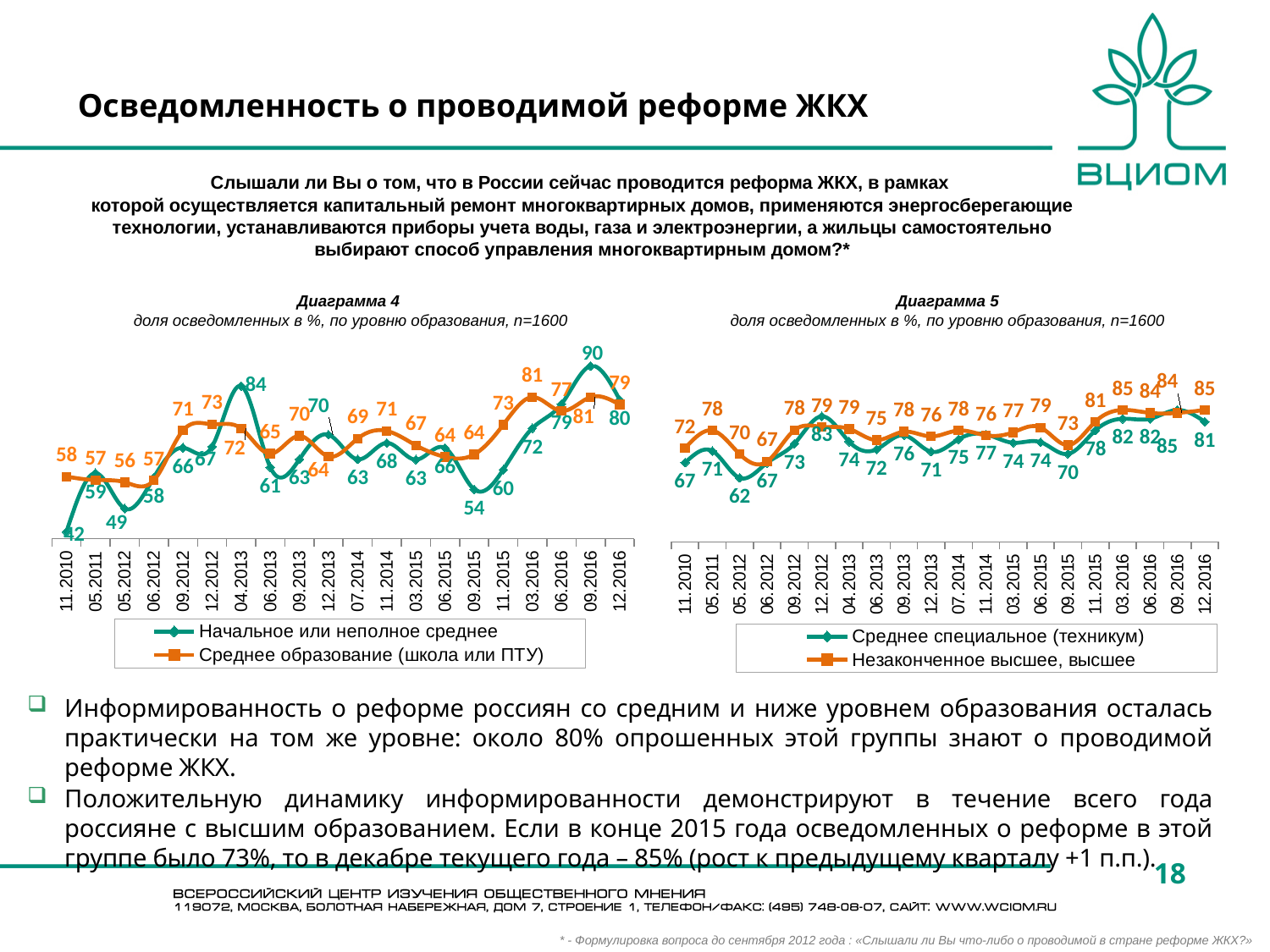
How many time points are plotted on Диаграмма 5? 20 On Диаграмма 4, in which period does 'Начальное или неполное среднее' reach its highest value? 09.2016 On Диаграмма 5, what is the value for 'Среднее специальное (техникум)' in 12.2012? 83 On Диаграмма 4, what is the value for 'Начальное или неполное среднее' in 09.2016? 90 On Диаграмма 5, which series has the larger value in 05.2012? Незаконченное высшее, высшее On Диаграмма 5, in which period does 'Среднее специальное (техникум)' reach its lowest value? 05.2012 On Диаграмма 5, what is the value for 'Незаконченное высшее, высшее' in 12.2016? 85 What type of chart is Диаграмма 4? Line chart On Диаграмма 4, what is the difference between the two series in 09.2016? 9 On Диаграмма 4, what is the value for 'Среднее образование (школа или ПТУ)' in 03.2016? 81 How many series does the legend of Диаграмма 4 list? 2 On Диаграмма 4, in which period does 'Начальное или неполное среднее' reach its lowest value? 11.2010